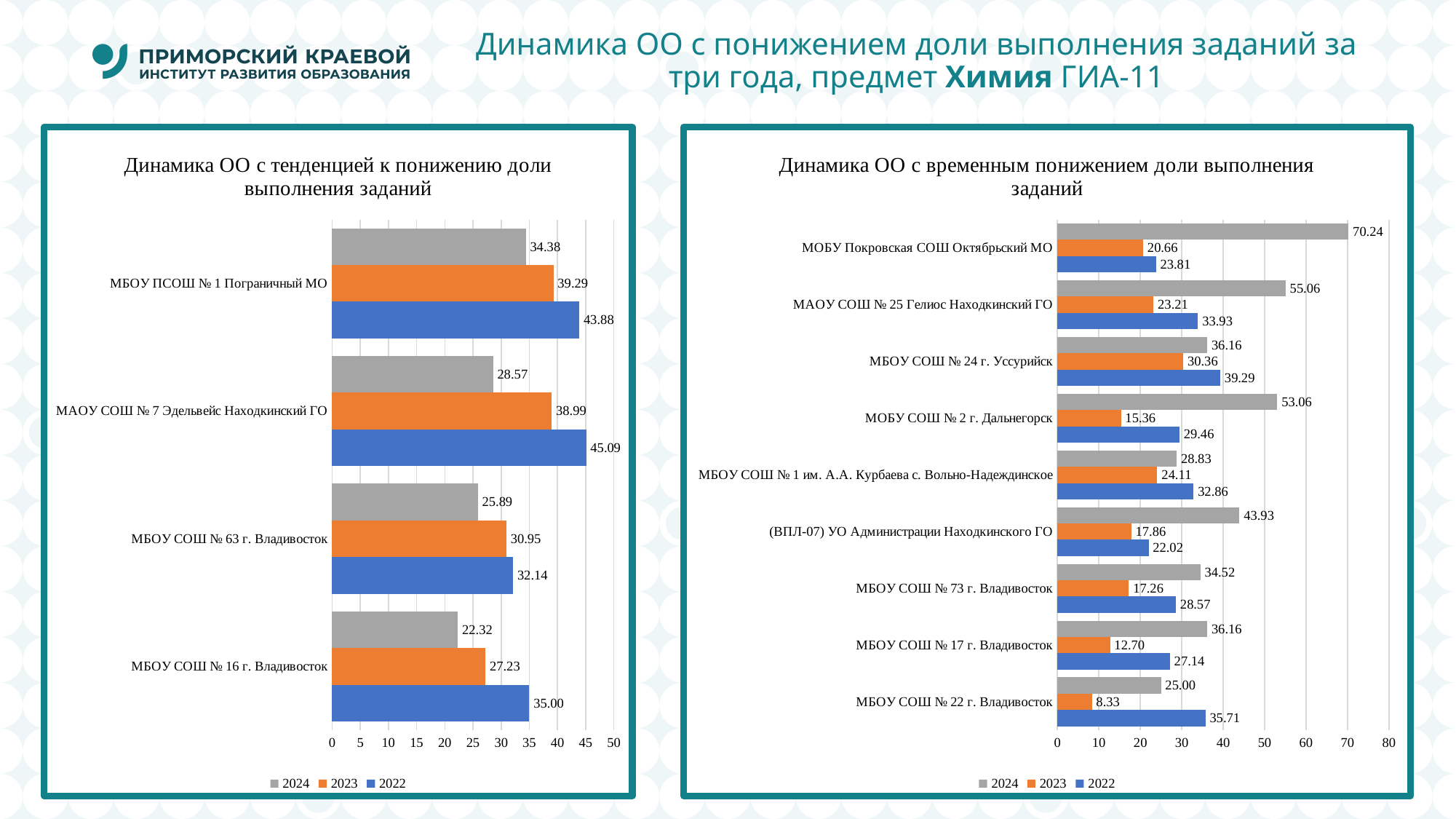
In the right chart (Динамика ОО с временным понижением доли выполнения заданий), what is the 2023 value for МБОУ СОШ № 22 г. Владивосток? 8.33 In the left chart (Динамика ОО с тенденцией к понижению доли выполнения заданий), what is the difference between the 2022 and 2024 values for МБОУ ПСОШ № 1 Пограничный МО? 9.50 What type of chart is the left chart (Динамика ОО с тенденцией к понижению доли выполнения заданий)? Bar chart In the left chart (Динамика ОО с тенденцией к понижению доли выполнения заданий), which school has the highest 2022 value? МАОУ СОШ № 7 Эдельвейс Находкинский ГО In the right chart (Динамика ОО с временным понижением доли выполнения заданий), which school has the lowest 2023 value? МБОУ СОШ № 22 г. Владивосток In the left chart (Динамика ОО с тенденцией к понижению доли выполнения заданий), what is the 2022 value for МБОУ СОШ № 16 г. Владивосток? 35.00 How many series does the legend of the right chart (Динамика ОО с временным понижением доли выполнения заданий) list? 3 In the right chart (Динамика ОО с временным понижением доли выполнения заданий), which is larger for МБОУ СОШ № 24 г. Уссурийск: the 2022 value or the 2023 value? 2022 In the left chart (Динамика ОО с тенденцией к понижению доли выполнения заданий), how many schools are shown? 4 In the right chart (Динамика ОО с временным понижением доли выполнения заданий), how many schools are shown? 9 In the right chart (Динамика ОО с временным понижением доли выполнения заданий), what is the 2024 value for МОБУ Покровская СОШ Октябрьский МО? 70.24 In the left chart (Динамика ОО с тенденцией к понижению доли выполнения заданий), what is the 2024 value for МАОУ СОШ № 7 Эдельвейс Находкинский ГО? 28.57